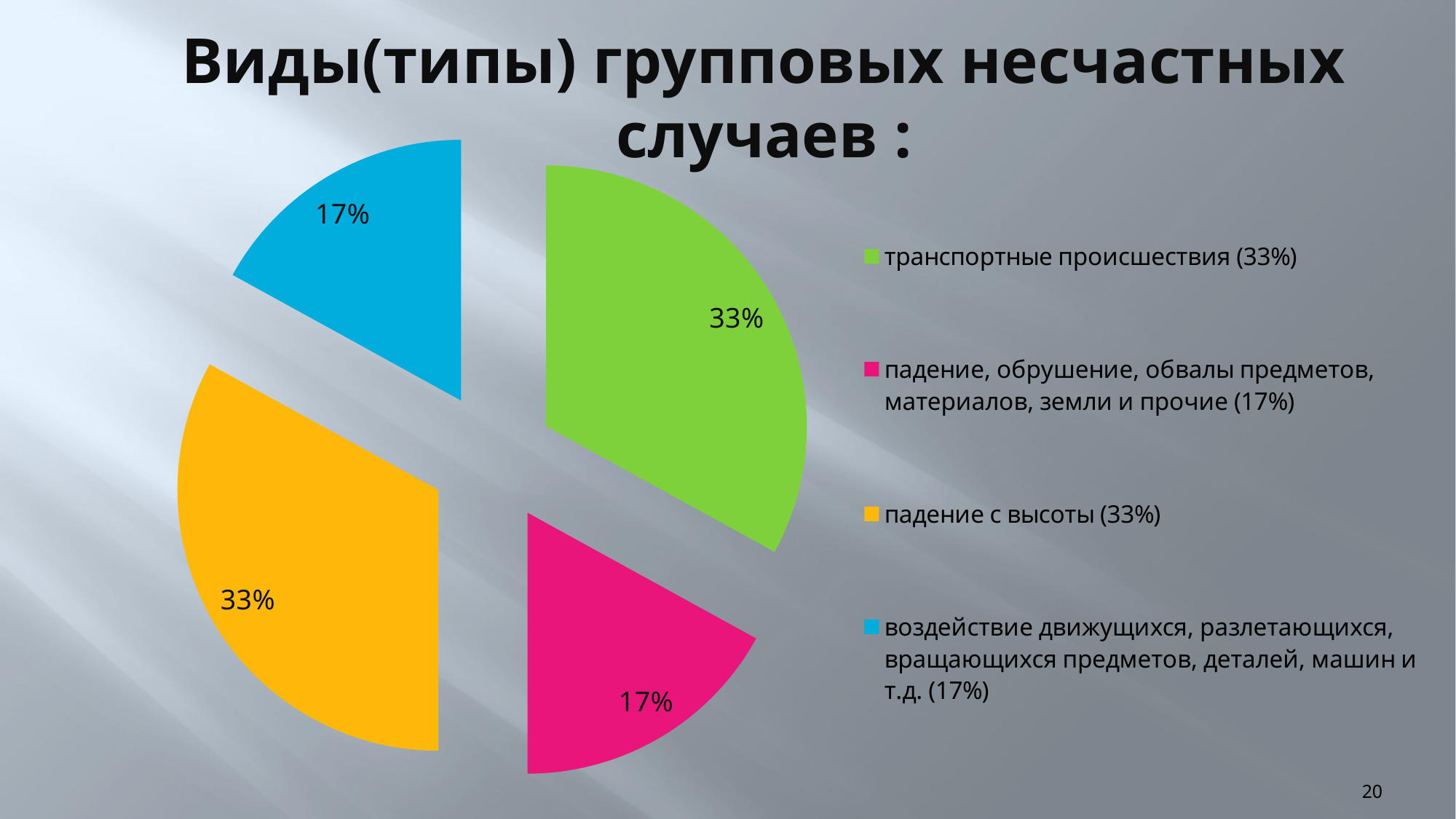
What is the value shown for 'воздействие движущихся, разлетающихся, вращающихся предметов, деталей, машин и т.д.'? 17% What is the difference between the share for 'транспортные происшествия' and the share for 'падение, обрушение, обвалы предметов, материалов, земли и прочие'? 16% What is the value shown for 'падение, обрушение, обвалы предметов, материалов, земли и прочие'? 17% Which is larger: 'транспортные происшествия' or 'падение, обрушение, обвалы предметов, материалов, земли и прочие'? транспортные происшествия Which is larger: 'падение с высоты' or 'воздействие движущихся, разлетающихся, вращающихся предметов, деталей, машин и т.д.'? падение с высоты How many entries does the legend list? 4 What colour is the slice for 'падение с высоты'? yellow What share of the pie is 'падение с высоты'? 33% What is the title of the slide? Виды(типы) групповых несчастных случаев : What share of the pie is 'транспортные происшествия'? 33% What kind of chart is shown on the slide? pie chart How many slices does the pie chart have? 4